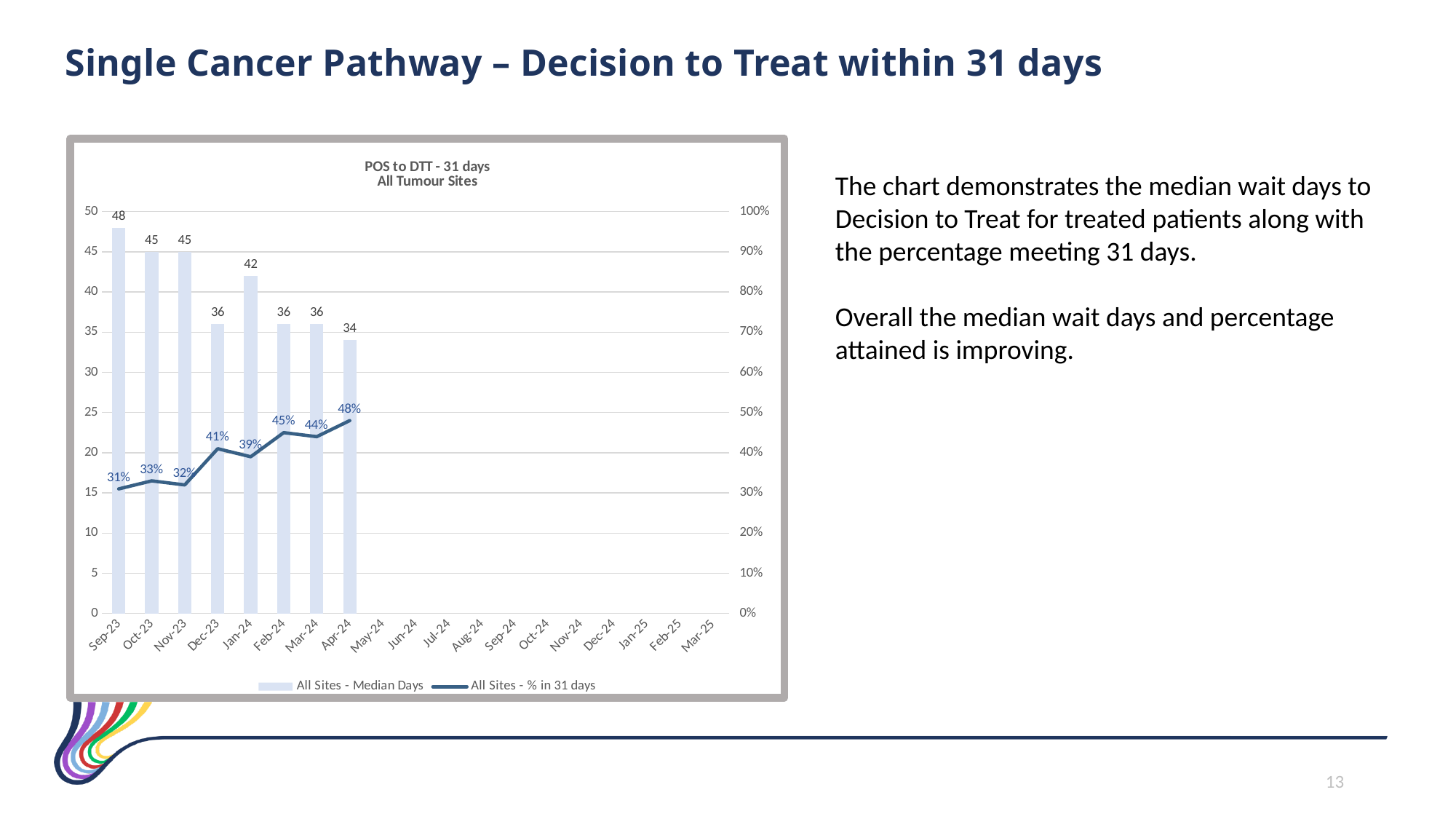
What is the median days value for Sep-23? 48 Which is larger, the percentage in 31 days for Feb-24 or Mar-24? Feb-24 Which month has the highest median days? Sep-23 Which month has the lowest percentage in 31 days? Sep-23 What is the title of the chart? POS to DTT - 31 days All Tumour Sites Which month has the lowest median days? Apr-24 How many series does the legend list? 2 What is the percentage in 31 days for Apr-24? 48% What kind of chart is shown? Combined bar and line chart How many months have plotted median days bars? 8 What is the difference in median days between Sep-23 and Apr-24? 14 What is the median days value for Jan-24? 42